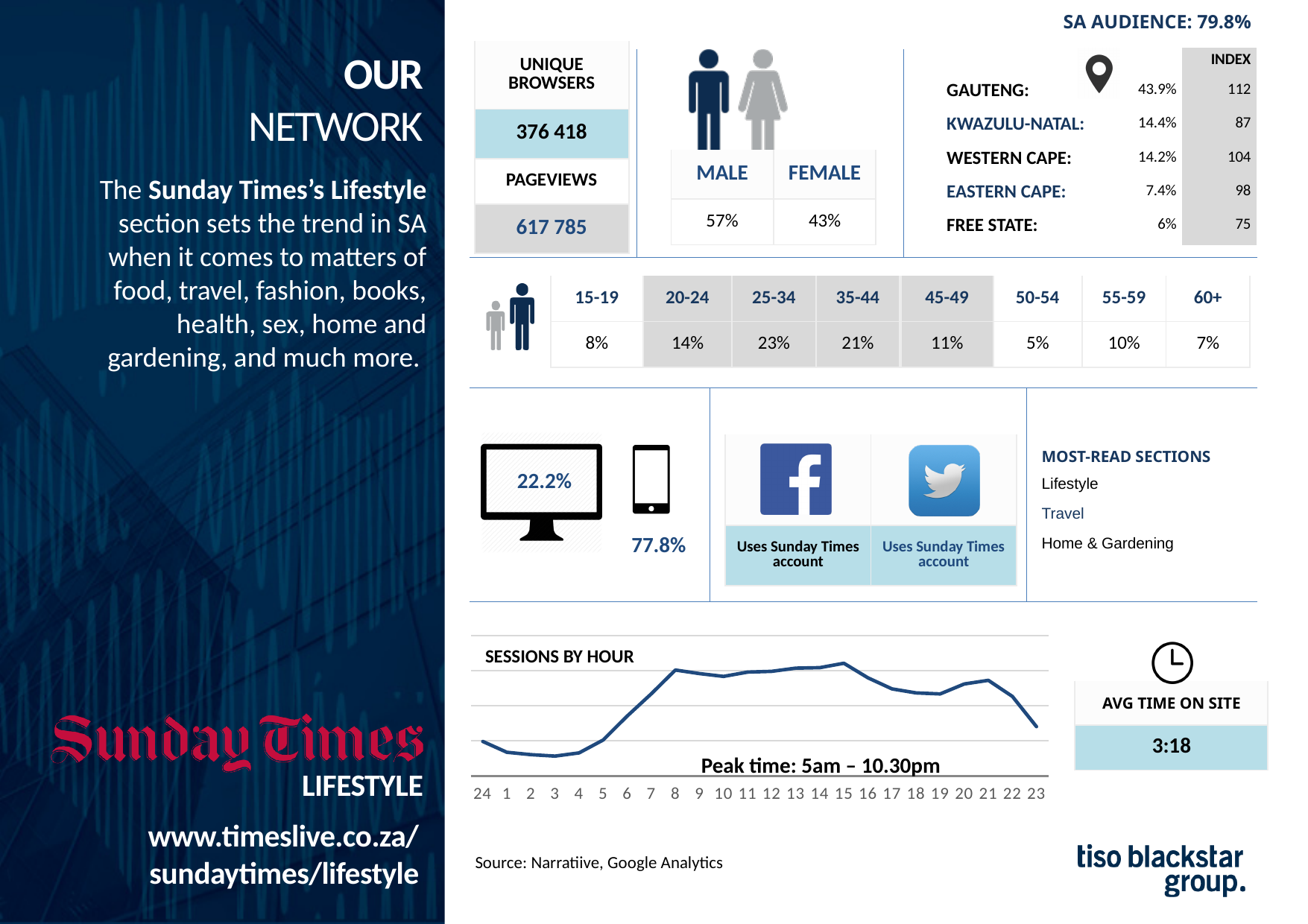
In the "SESSIONS BY HOUR" chart, do sessions rise or fall between hour 21 and hour 23? fall In the "SESSIONS BY HOUR" chart, do sessions rise or fall between hour 15 and hour 18? fall How many lines (series) are plotted in the "SESSIONS BY HOUR" chart? 1 What is the title of the line chart at the bottom of the slide? SESSIONS BY HOUR In the "SESSIONS BY HOUR" chart, are sessions higher at hour 1 or at hour 12? 12 In the "SESSIONS BY HOUR" chart, are sessions higher at hour 8 or at hour 3? 8 In the "SESSIONS BY HOUR" chart, do sessions rise or fall between hour 5 and hour 8? rise In the "SESSIONS BY HOUR" chart, which hour has the highest number of sessions? 15 What kind of chart is the "SESSIONS BY HOUR" chart? line chart What peak time is annotated on the "SESSIONS BY HOUR" chart? 5am – 10.30pm In the "SESSIONS BY HOUR" chart, are sessions higher at hour 21 or at hour 23? 21 How many hour points are plotted along the x axis of the "SESSIONS BY HOUR" chart? 24